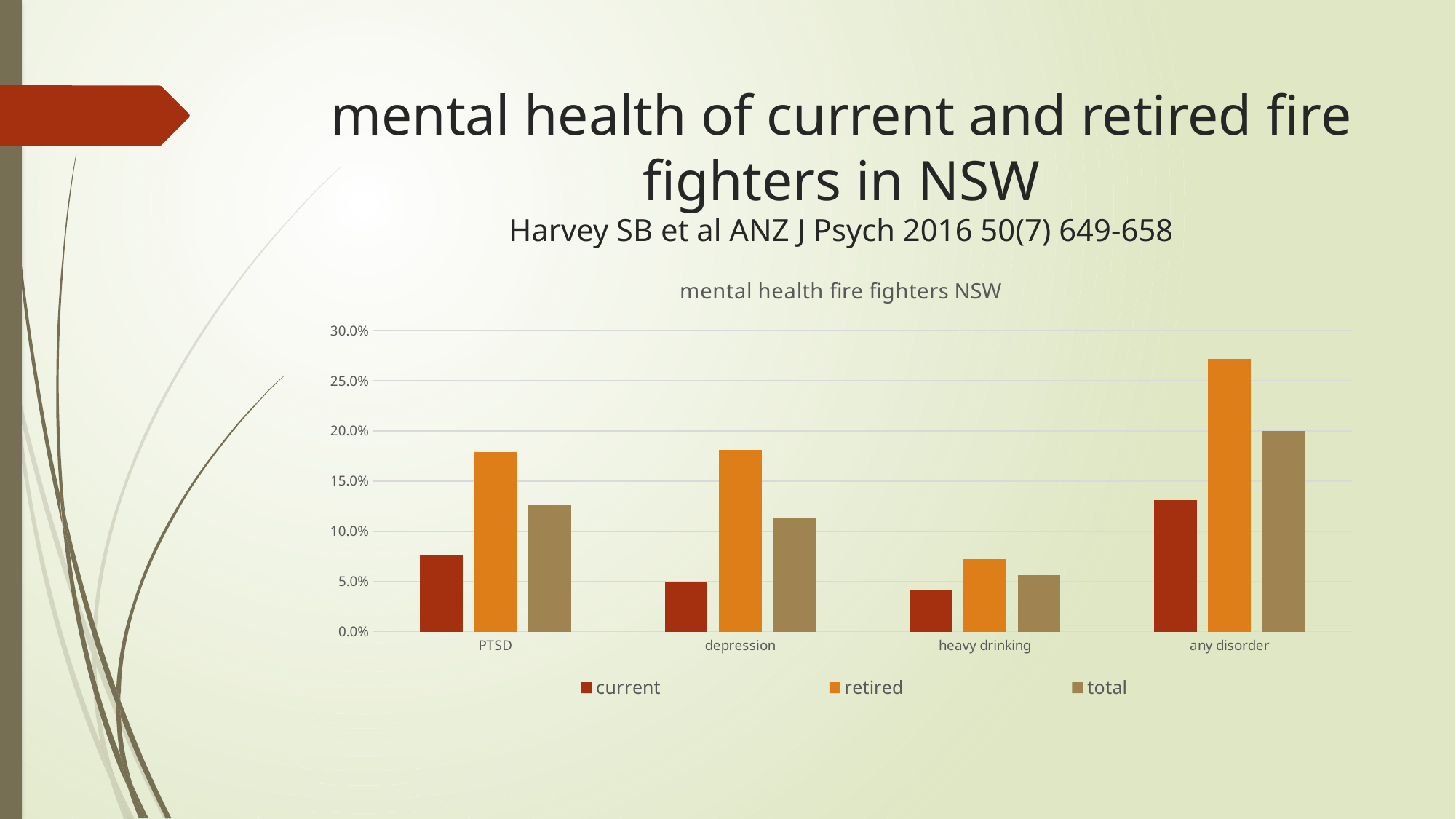
Is the value for retired in the any disorder category greater or less than 25.0%? greater Is the value for current in the heavy drinking category greater or less than 5.0%? less What is the title of the chart? mental health fire fighters NSW Which series is shown in orange in the chart? retired Which is larger for the current series: the PTSD value or the depression value? PTSD Is the value for retired in the PTSD category greater or less than 15.0%? greater What kind of chart is shown on the slide? bar chart For the retired series, which category has the highest value? any disorder How many categories are shown on the x axis of the chart? 4 How many series does the chart legend list? 3 For the current series, which category has the lowest value? heavy drinking